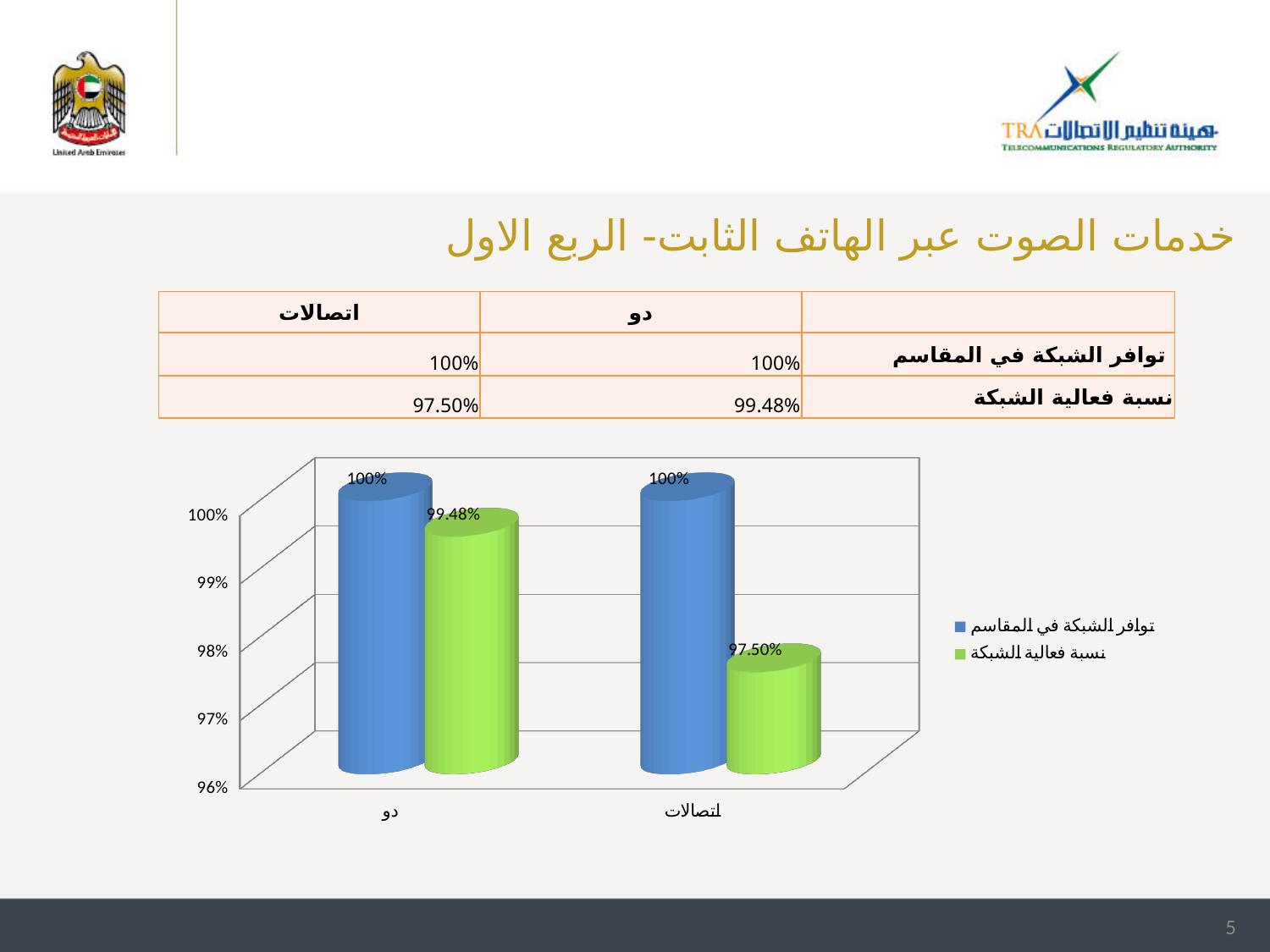
Is the نسبة فعالية الشبكة value for دو larger or smaller than the value for اتصالات? larger What type of chart is shown on the slide? bar chart How many series does the chart legend list? 2 How many categories are shown on the x axis of the chart? 2 What is the value of نسبة فعالية الشبكة for دو? 99.48% What is the value of توافر الشبكة في المقاسم for اتصالات? 100% Which operator has the higher value for نسبة فعالية الشبكة? دو What is the difference between the نسبة فعالية الشبكة values for دو and اتصالات? 1.98% Which operator has the lower value for نسبة فعالية الشبكة? اتصالات What is the value of نسبة فعالية الشبكة for اتصالات? 97.50% What is the value of توافر الشبكة في المقاسم for دو? 100% Is the value of نسبة فعالية الشبكة for اتصالات greater or less than 98%? less